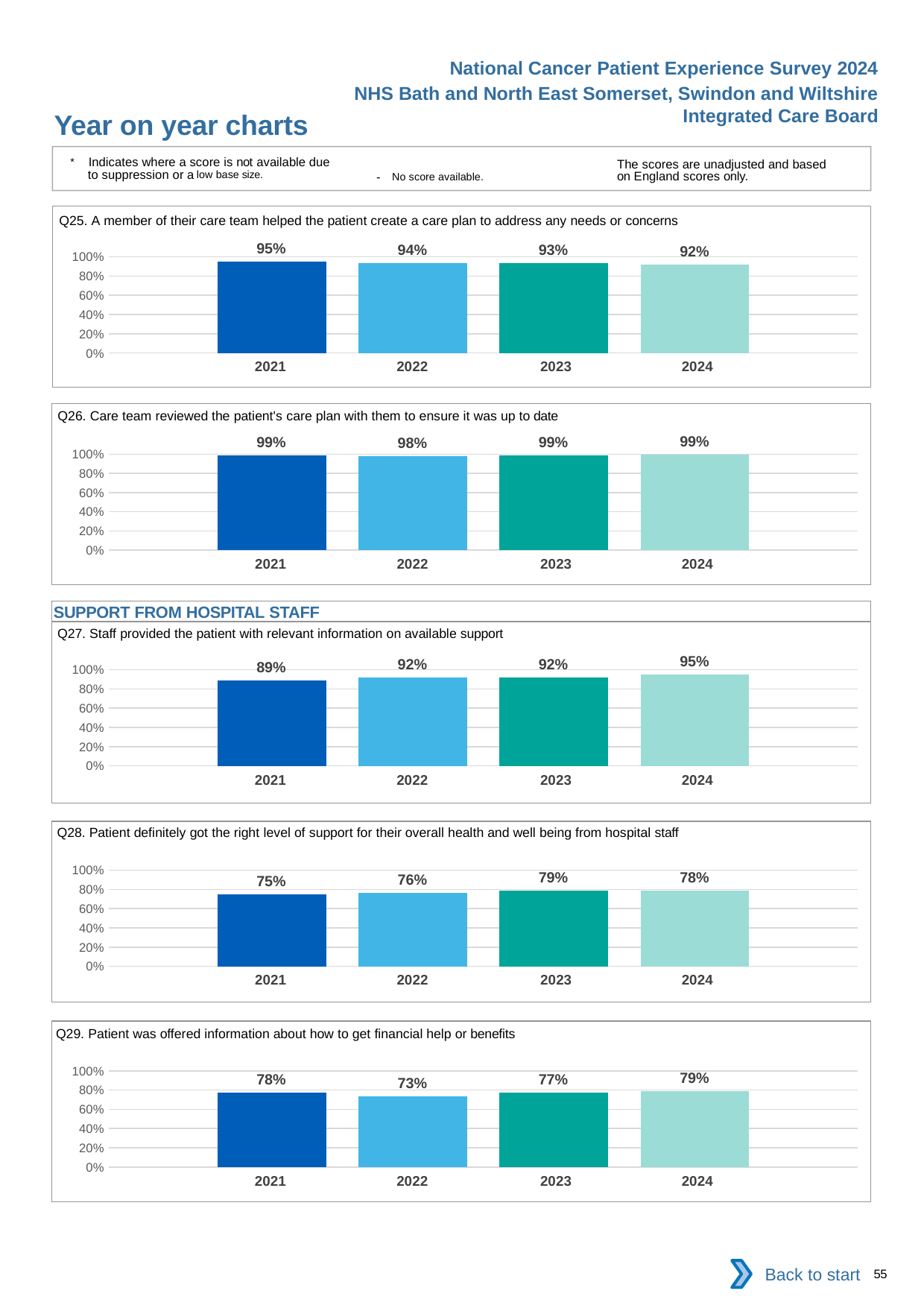
In the Q28 chart, is the value for 2021 greater or less than 80%? less In the Q27 chart, what is the difference between the 2024 and 2021 values? 6% In the Q28 chart, which year has the highest value? 2023 In the Q25 chart, do the values rise or fall from 2021 to 2024? fall In the Q29 chart, which year has the lowest value? 2022 In the Q26 chart, which year has the lowest value? 2022 How many years are shown in the Q29 chart? 4 In the Q29 chart, what is the difference between the 2021 and 2022 values? 5% In the Q27 chart, which year has the highest value? 2024 What kind of chart is the Q28 chart? bar chart In the Q26 chart, what is the value for 2024? 99% In the Q25 chart, what is the value for 2021? 95%